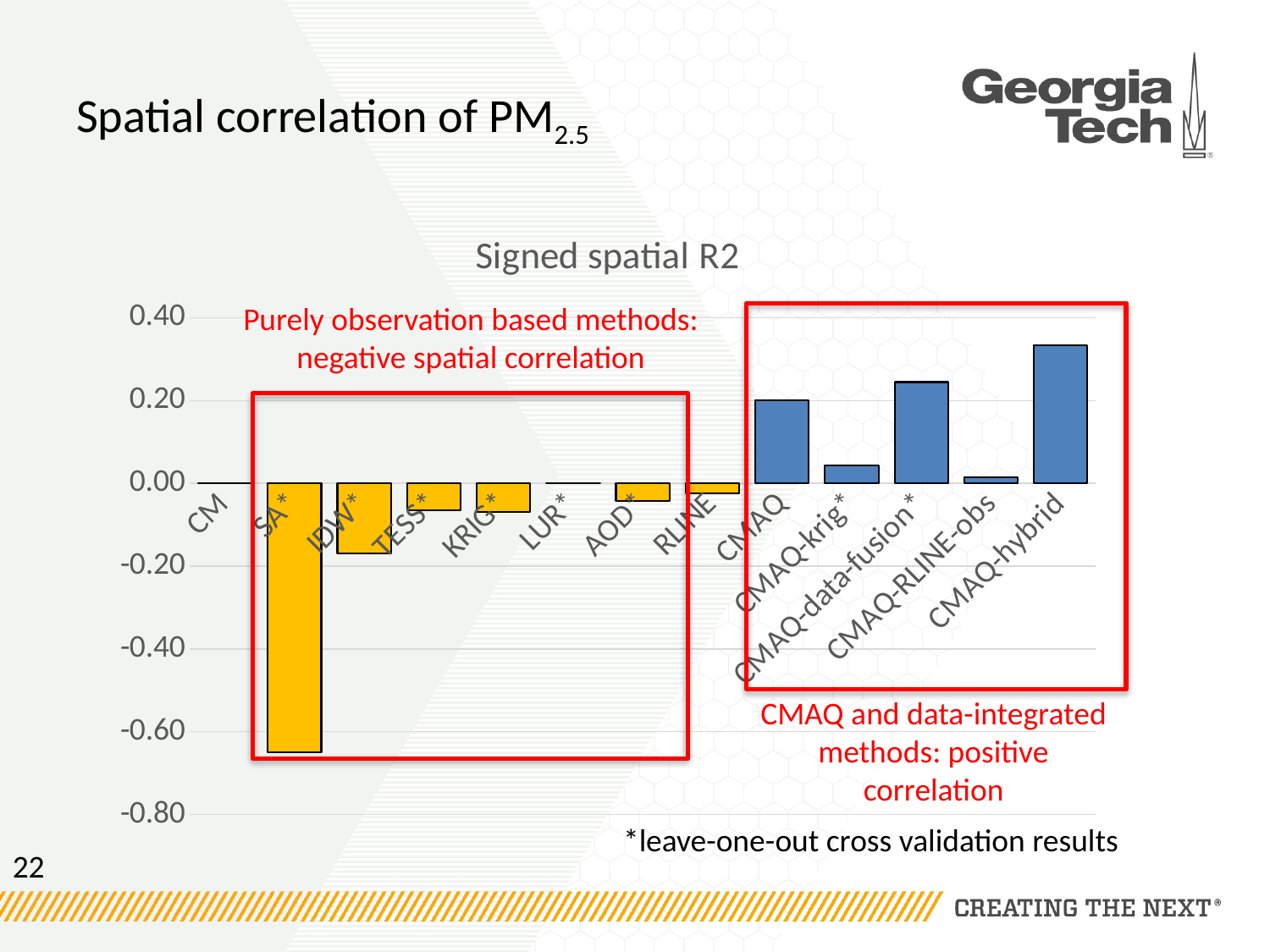
How many categories are shown on the x axis of the chart? 13 Is the value for CMAQ-hybrid greater or less than 0.20? greater Is the value for SA* greater or less than -0.60? less Which has the larger value, CMAQ-data-fusion* or CMAQ-krig*? CMAQ-data-fusion* Which has the lower value, SA* or IDW*? SA* What kind of chart is shown on the slide? bar chart Which category has the lowest signed spatial R2? SA* What colour are the bars for the CMAQ and data-integrated methods? blue Which has the larger value, CMAQ-hybrid or CMAQ? CMAQ-hybrid What is the title of the chart? Signed spatial R2 Is the value for CMAQ-data-fusion* greater or less than 0.20? greater Which category has the highest signed spatial R2? CMAQ-hybrid